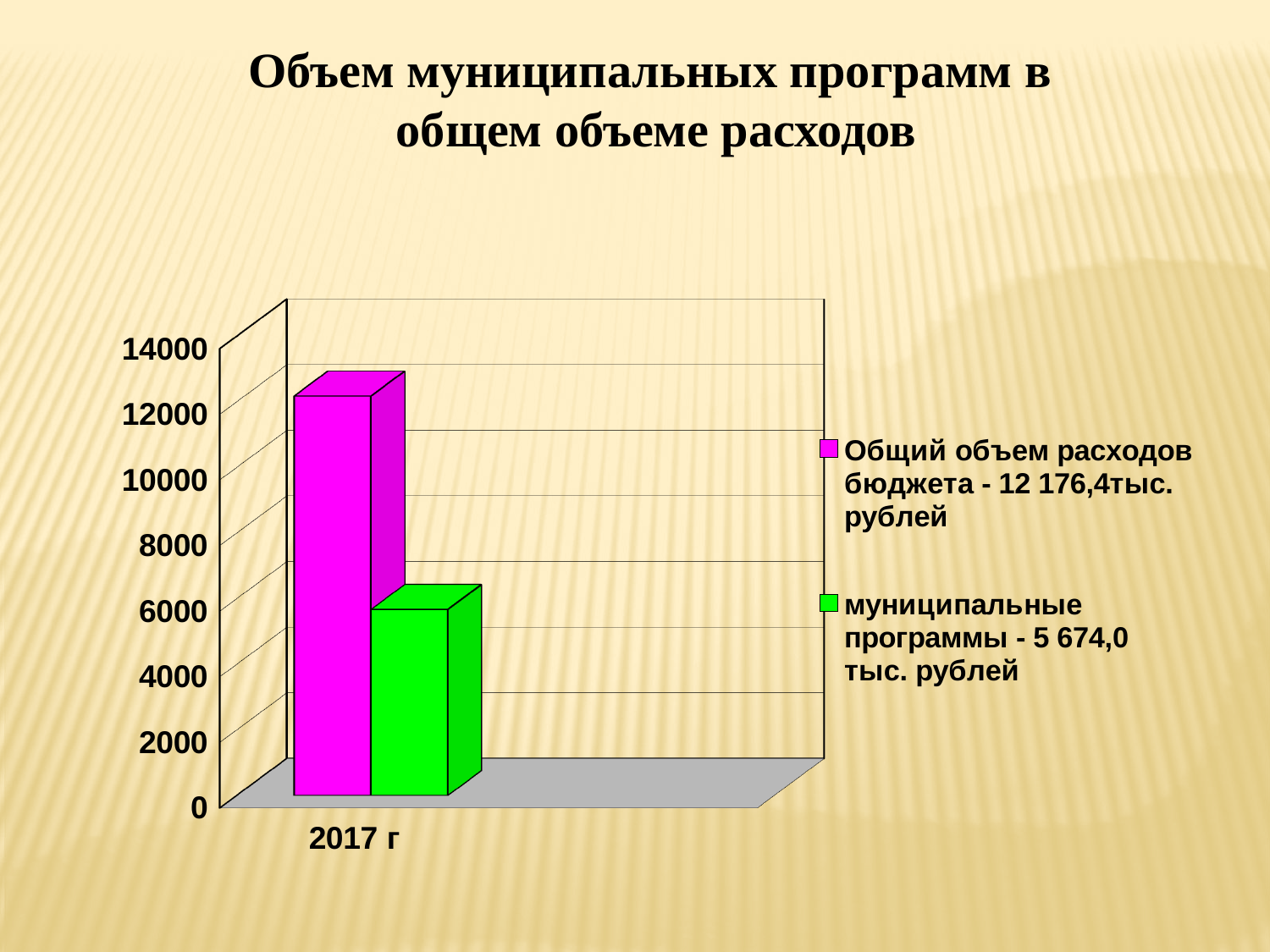
Is the value for 'муниципальные программы' greater or less than 8000? less Which series has the higher value: 'Общий объем расходов бюджета' or 'муниципальные программы'? Общий объем расходов бюджета What kind of chart is shown on the slide? bar chart According to the legend, what is the value of 'муниципальные программы'? 5 674,0 тыс. рублей How many series does the legend list? 2 What is the difference between 'Общий объем расходов бюджета' and 'муниципальные программы'? 6 502,4 тыс. рублей How many categories are shown on the x axis? 1 What is the title of the chart on the slide? Объем муниципальных программ в общем объеме расходов Which series has the lowest bar? муниципальные программы Is the value for 'Общий объем расходов бюджета' greater or less than 10000? greater According to the legend, what is the value of 'Общий объем расходов бюджета'? 12 176,4 тыс. рублей Which year is shown on the x axis? 2017 г